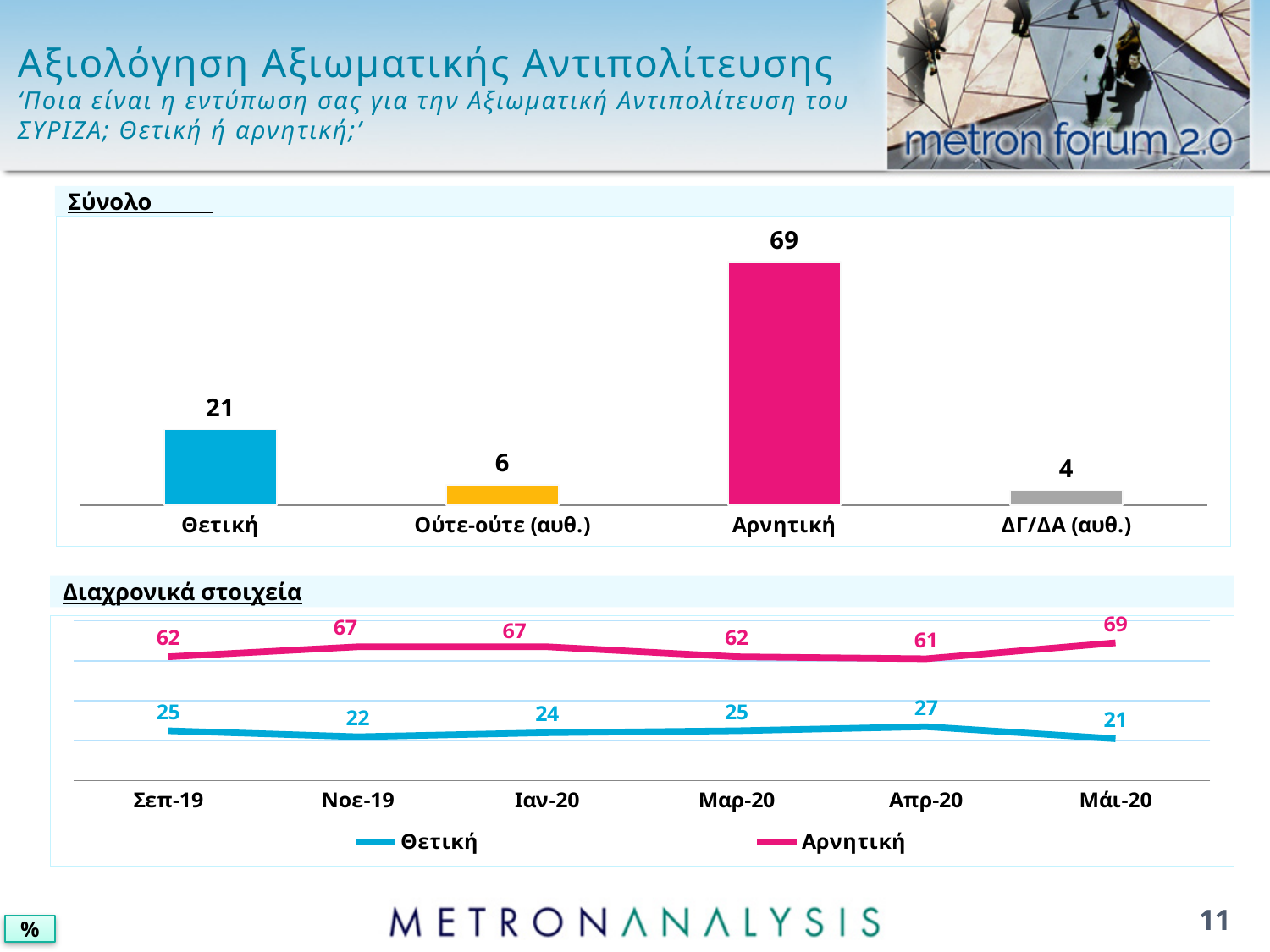
In the 'Σύνολο' bar chart, what is the difference between Αρνητική and Θετική? 48 What kind of chart is the 'Σύνολο' chart? bar chart In the 'Σύνολο' bar chart, which category has the lowest value? ΔΓ/ΔΑ (αυθ.) In the 'Σύνολο' bar chart, how many categories are shown? 4 In the 'Σύνολο' bar chart, what is the value for Αρνητική? 69 In the 'Διαχρονικά στοιχεία' line chart, what is the value of Θετική for Νοε-19? 22 In the 'Διαχρονικά στοιχεία' line chart, what is the value of Αρνητική for Απρ-20? 61 In the 'Σύνολο' bar chart, what is the value for Θετική? 21 In the 'Διαχρονικά στοιχεία' line chart, is Θετική higher in Σεπ-19 or in Μάι-20? Σεπ-19 In the 'Διαχρονικά στοιχεία' line chart, how many series does the legend list? 2 In the 'Διαχρονικά στοιχεία' line chart, at which date is Θετική highest? Απρ-20 In the 'Διαχρονικά στοιχεία' line chart, what is the difference between Αρνητική and Θετική in Μαρ-20? 37